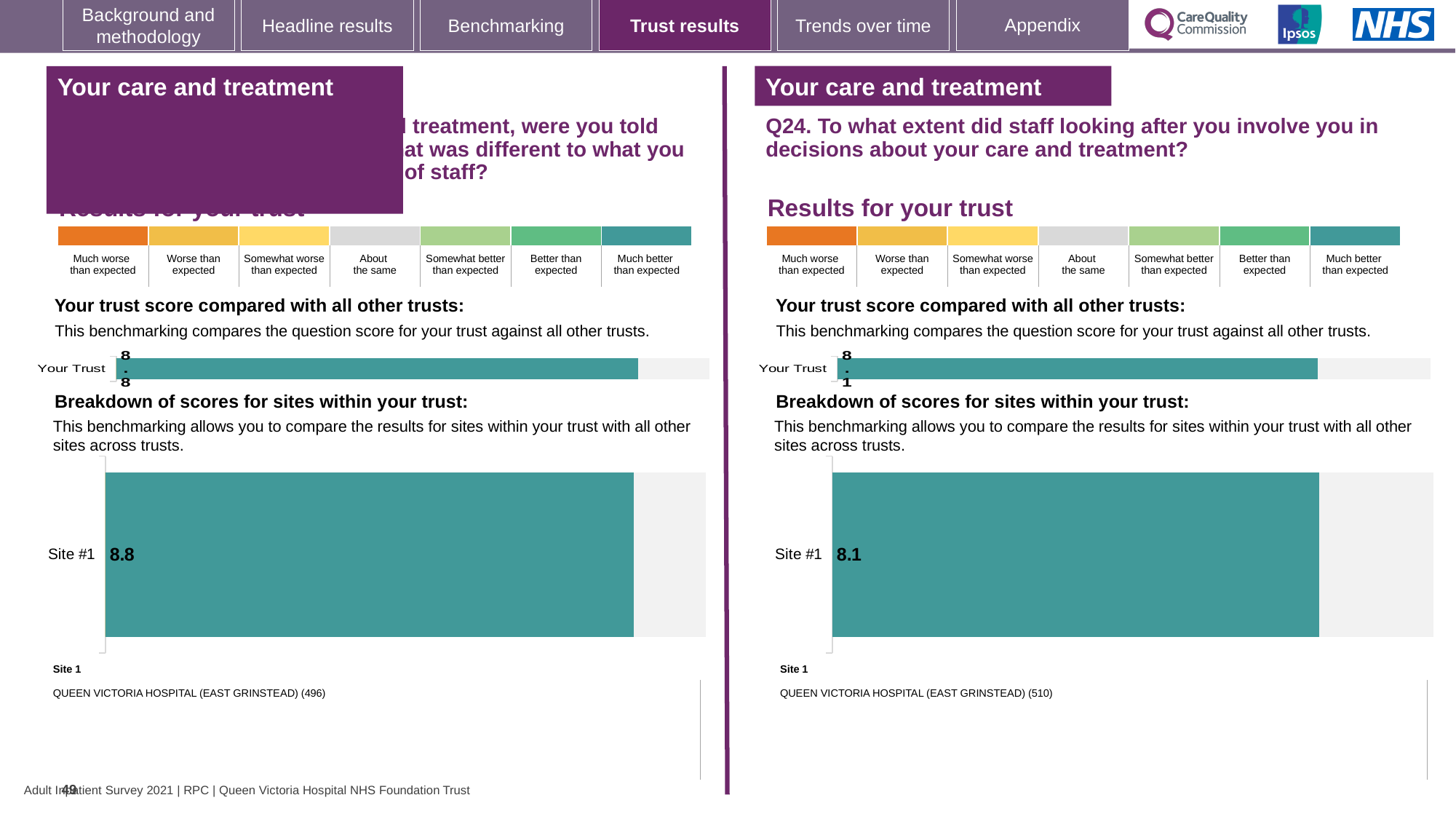
On the right panel (Q24) 'Breakdown of scores for sites within your trust' chart, what is the score for Site #1? 8.1 How many categories are shown in the colour scale legend above 'Your trust score compared with all other trusts' on the right panel (Q24)? 7 What type of chart is used to show 'Your Trust' score on the left panel? Bar chart On the left panel's 'Your trust score compared with all other trusts' chart, what is the score shown for Your Trust? 8.8 How many sites are shown in the left panel's 'Breakdown of scores for sites within your trust' chart? 1 On the left panel's 'Breakdown of scores for sites within your trust' chart, what is the score for Site #1? 8.8 How many sites are shown in the right panel (Q24) 'Breakdown of scores for sites within your trust' chart? 1 What is the difference between the Site #1 score on the left panel and the Site #1 score on the right panel (Q24)? 0.7 On the right panel (Q24) 'Your trust score compared with all other trusts' chart, what is the score shown for Your Trust? 8.1 Which Site #1 score is larger: the one on the left panel or the one on the right panel (Q24)? Left panel On the right panel (Q24), which hospital is listed as Site 1? QUEEN VICTORIA HOSPITAL (EAST GRINSTEAD) (510) What type of chart is used for the Site #1 breakdown on the right panel (Q24)? Bar chart